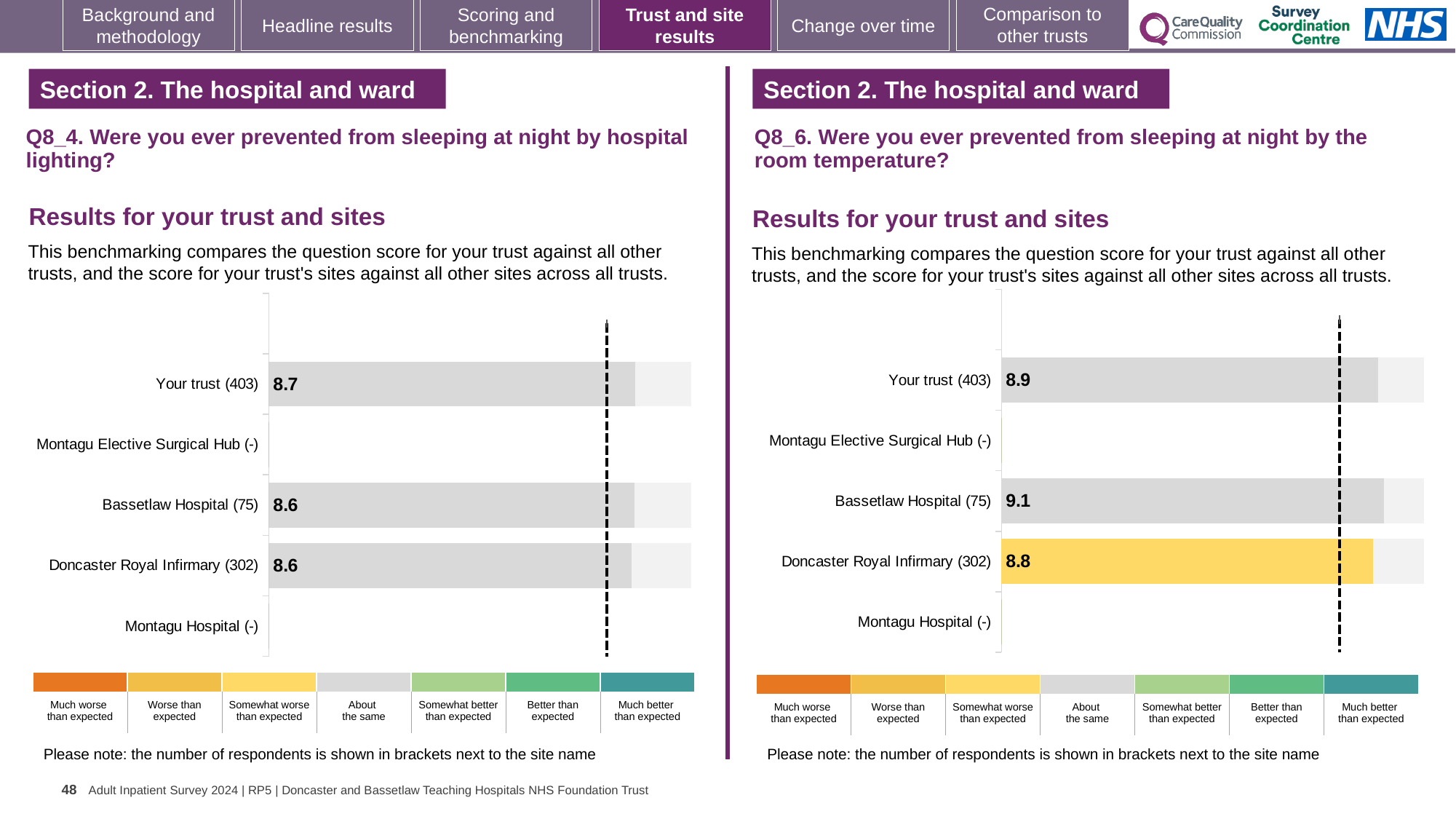
Which is larger: the Your trust (403) score on the Q8_4 chart or the Your trust (403) score on the Q8_6 chart? Q8_6 chart On the Q8_6 chart (room temperature), which site or trust has the highest score? Bassetlaw Hospital (75) What kind of chart is used on the Q8_6 chart (room temperature)? Bar chart On the Q8_4 chart (hospital lighting), what is the score for Your trust (403)? 8.7 On the Q8_4 chart (hospital lighting), what is the difference between the scores for Your trust (403) and Doncaster Royal Infirmary (302)? 0.1 How many rows (sites and trust) are listed on the Q8_4 chart (hospital lighting)? 5 On the Q8_6 chart (room temperature), what is the score for Bassetlaw Hospital (75)? 9.1 On the Q8_4 chart (hospital lighting), which row has the highest score? Your trust (403) On the Q8_6 chart (room temperature), what is the score for Doncaster Royal Infirmary (302)? 8.8 On the Q8_6 chart (room temperature), what is the difference between the scores for Bassetlaw Hospital (75) and Doncaster Royal Infirmary (302)? 0.3 On the Q8_4 chart (hospital lighting), what is the score for Bassetlaw Hospital (75)? 8.6 On the Q8_6 chart (room temperature), which site's bar is coloured yellow (somewhat worse than expected)? Doncaster Royal Infirmary (302)